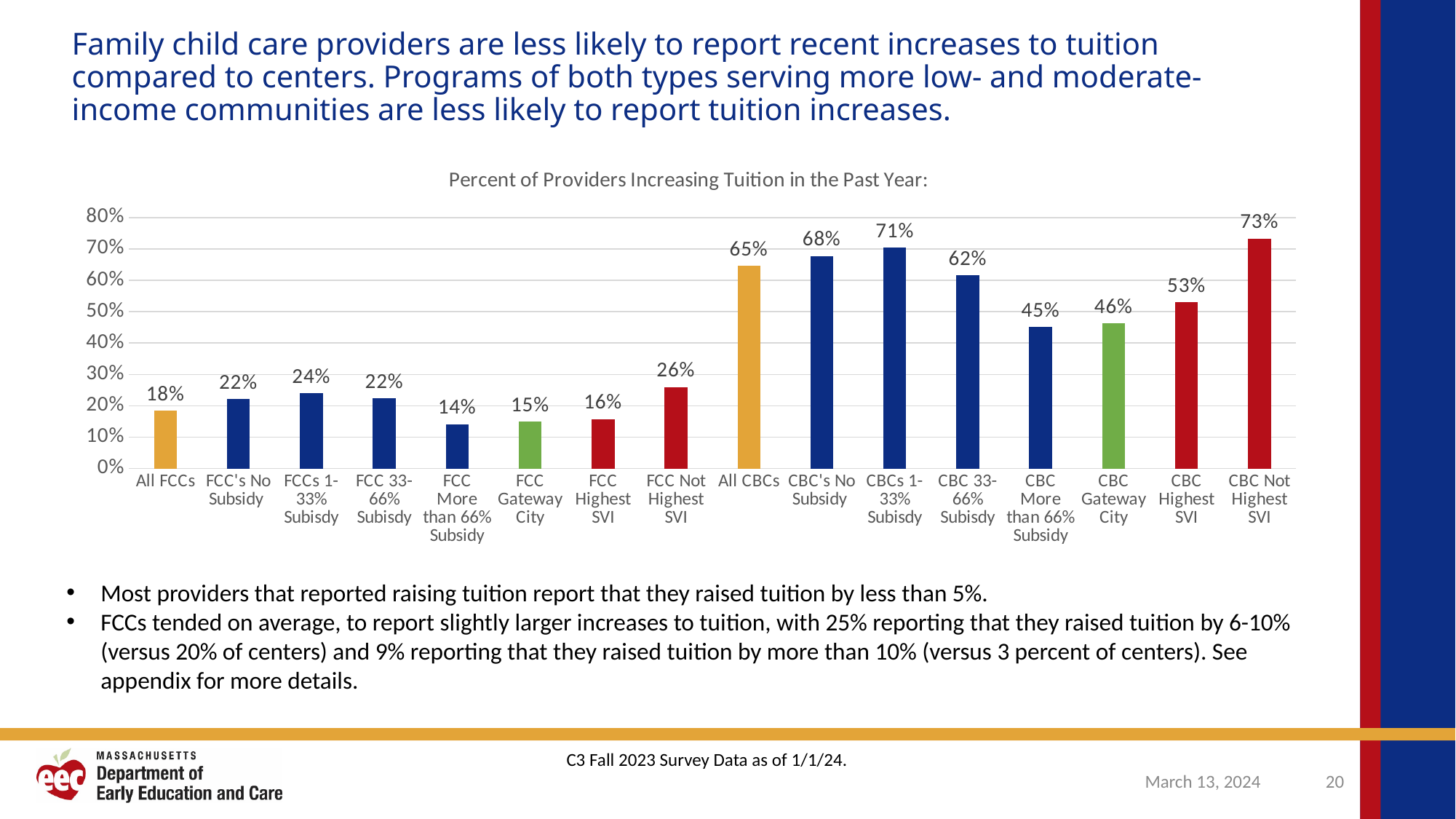
What kind of chart is this? Bar chart Which is larger, FCC Not Highest SVI or FCC Highest SVI? FCC Not Highest SVI Which category has the highest value? CBC Not Highest SVI What is the value for CBC Gateway City? 46% What is the value for All FCCs? 18% What is the difference between CBC Not Highest SVI and CBC Highest SVI? 20% What is the difference between All CBCs and All FCCs? 47% What is the title of the chart? Percent of Providers Increasing Tuition in the Past Year: What is the value for CBC Not Highest SVI? 73% Which category has the lowest value? FCC More than 66% Subsidy How many categories are shown on the x axis? 16 What is the value for FCC More than 66% Subsidy? 14%